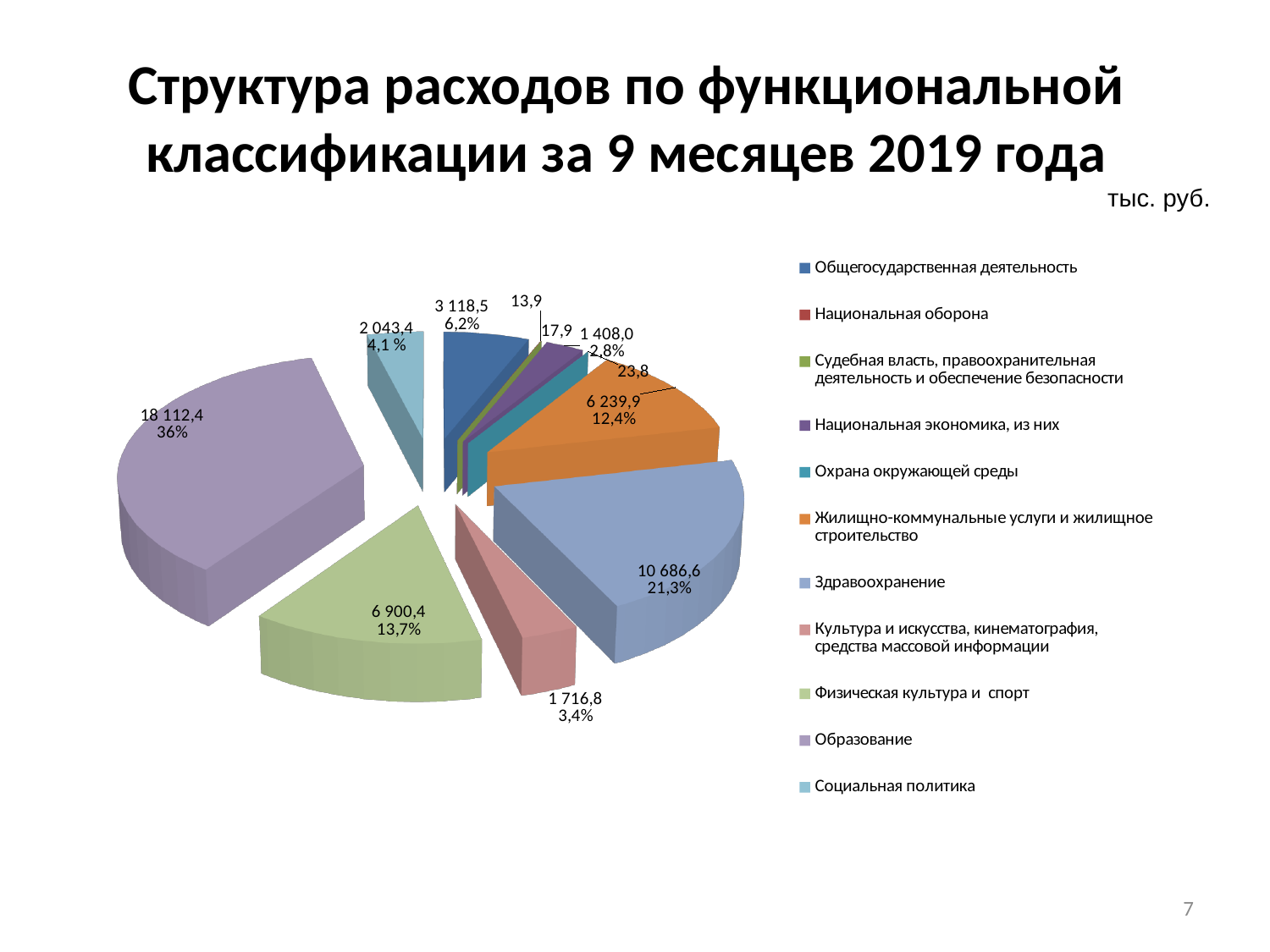
What is the value for Физическая культура и спорт? 6 900,4 What share of the pie does Здравоохранение represent? 21,3% Which category has the largest share of the pie? Образование What is the value for Жилищно-коммунальные услуги и жилищное строительство? 6 239,9 Which is larger, the value for Физическая культура и спорт or for Жилищно-коммунальные услуги и жилищное строительство? Физическая культура и спорт What type of chart is shown on the slide? pie chart What is the value for Социальная политика? 2 043,4 What share of the pie does Образование represent? 36% What is the value for Здравоохранение? 10 686,6 What is the difference between the values for Образование and Здравоохранение? 7 425,8 What is the value for Образование? 18 112,4 How many categories does the legend list? 11